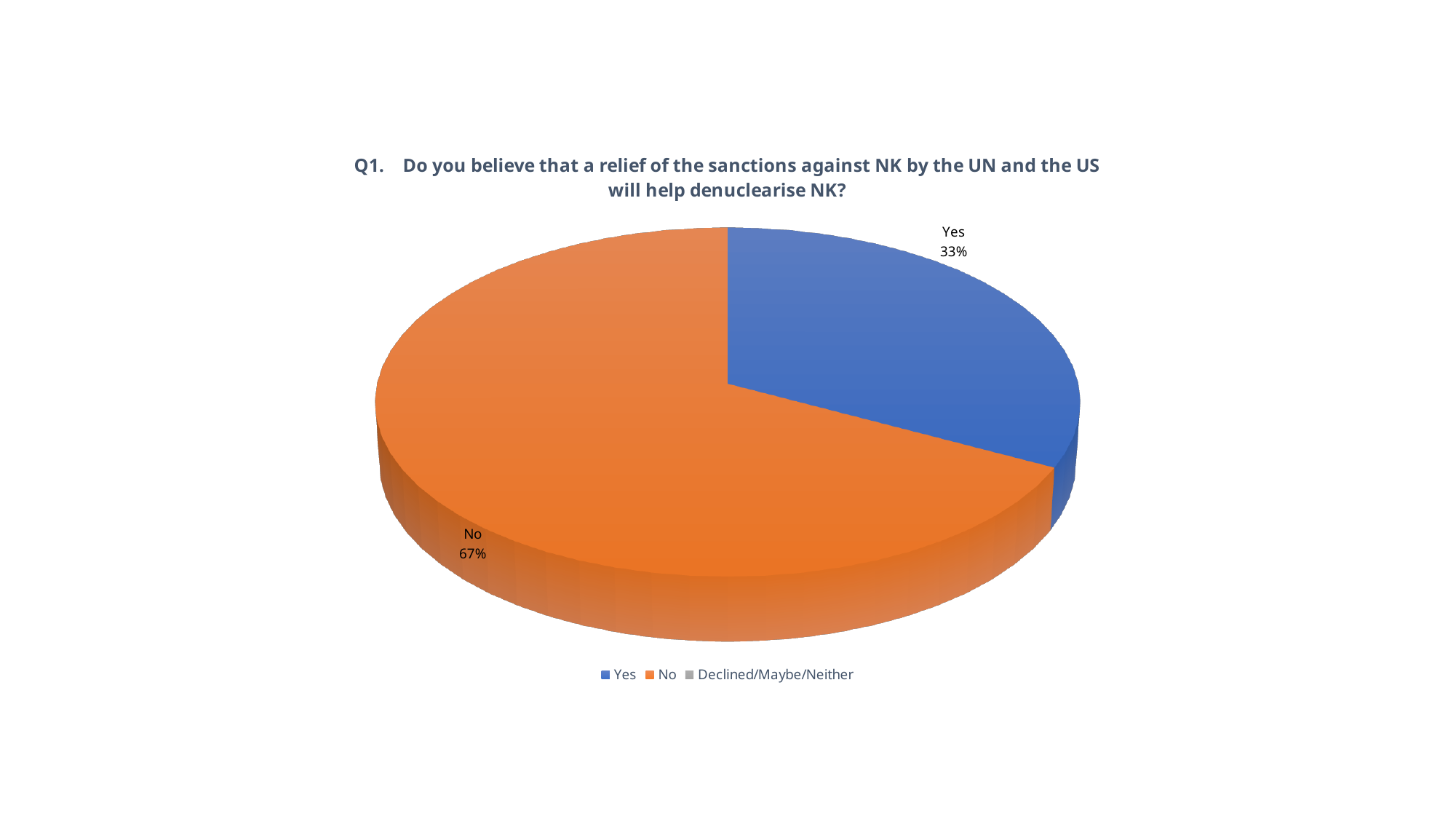
By how many percentage points does the "No" share exceed the "Yes" share? 34 percentage points Which response has the largest share of the pie? No What kind of chart is shown on the slide? Pie chart How many entries does the legend list? 3 What is the third legend entry, after Yes and No? Declined/Maybe/Neither What is the combined share of the "Yes" and "No" slices? 100% What share of the pie is labelled "No"? 67% What colour is the "No" slice of the pie? Orange Which of the two labelled slices, Yes or No, is smaller? Yes What share of the pie is labelled "Yes"? 33% Is the share for "Yes" larger or smaller than the share for "No"? smaller